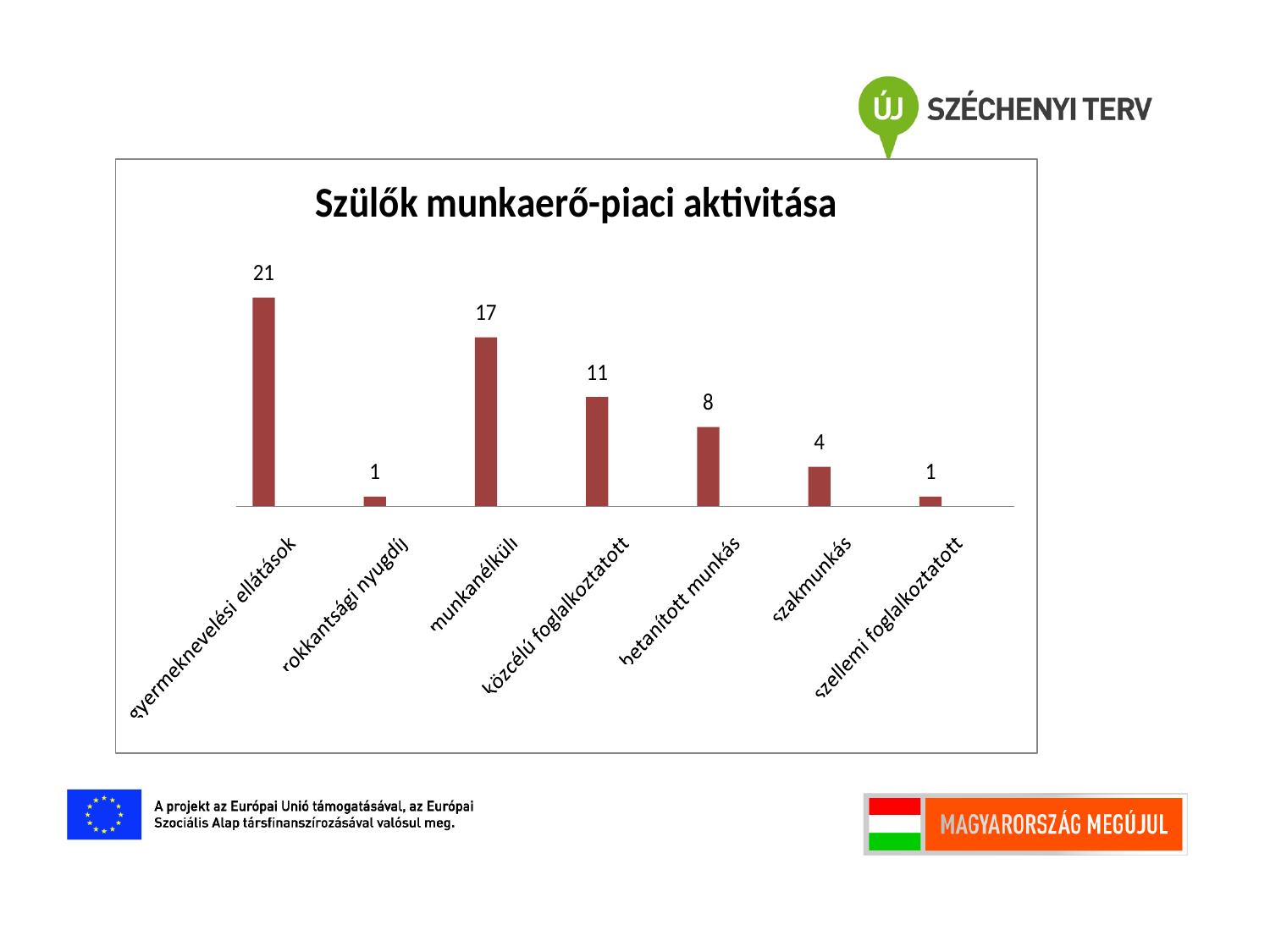
What is the value for rokkantsági nyugdíj? 1 What is the title of the chart? Szülők munkaerő-piaci aktivitása Which is larger, the value for betanított munkás or the value for szakmunkás? betanított munkás What kind of chart is shown on the slide? bar chart What is the value for betanított munkás? 8 What is the value for szakmunkás? 4 Which category has the highest value? gyermeknevelési ellátások What is the difference between the values for közcélú foglalkoztatott and betanított munkás? 3 What is the value for közcélú foglalkoztatott? 11 What is the difference between the values for gyermeknevelési ellátások and munkanélküli? 4 How many categories are shown on the x axis? 7 What is the value for munkanélküli? 17